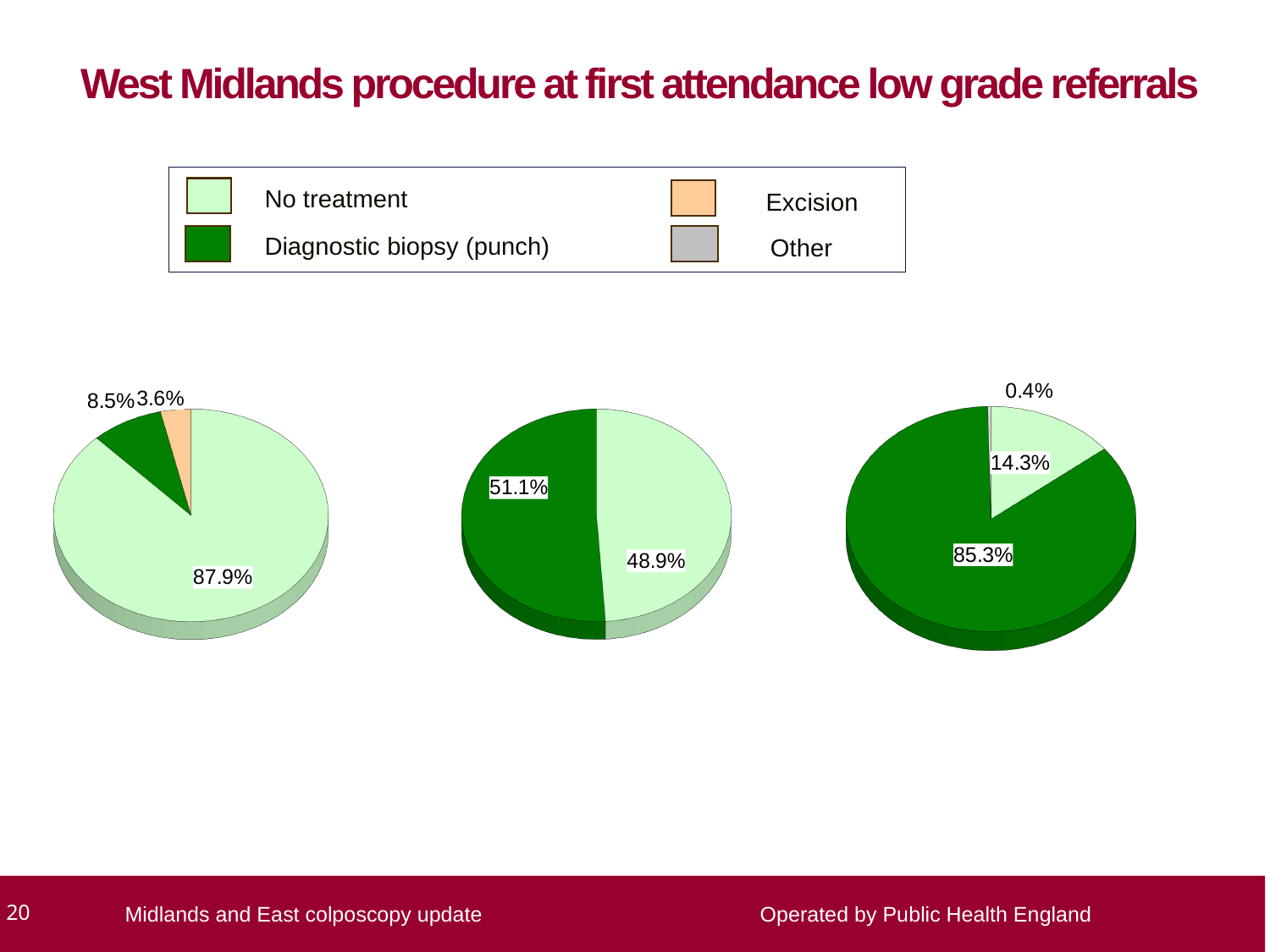
What kind of charts are shown on the slide? Pie charts In the right pie chart, what share is labelled for Diagnostic biopsy (punch)? 85.3% In the left pie chart, what share is labelled for Diagnostic biopsy (punch)? 8.5% In the middle pie chart, what share is labelled for Diagnostic biopsy (punch)? 51.1% How many categories does the legend list? 4 In the right pie chart, what is the difference between the Diagnostic biopsy (punch) share and the No treatment share? 71.0% In the left pie chart, which category has the smallest slice? Excision In the middle pie chart, what share is labelled for No treatment? 48.9% In the right pie chart, which category has the largest slice? Diagnostic biopsy (punch) In the right pie chart, what share is labelled for Other? 0.4% In the left pie chart, what share is labelled for Excision? 3.6% In the left pie chart, what share is labelled for No treatment? 87.9%